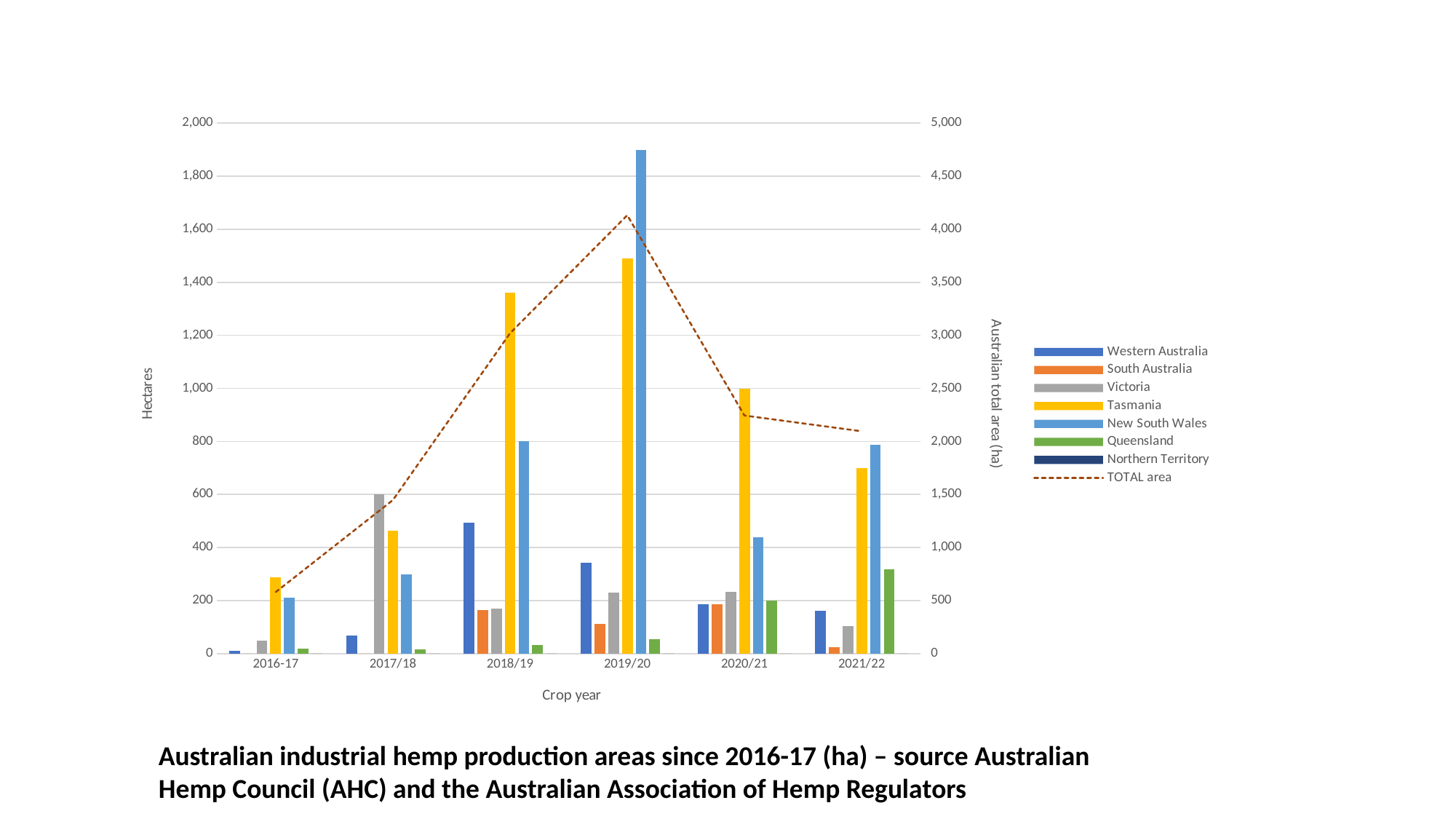
How many entries does the legend list? 8 How many crop years are shown on the x axis? 6 In which crop year does the TOTAL area line reach its peak? 2019/20 In 2018/19, which is larger: the Tasmania bar or the New South Wales bar? Tasmania What kind of chart is shown on the slide? bar chart (with a dashed line for total area) Does the TOTAL area line rise or fall from 2016-17 to 2019/20? rise Which state has the tallest bar in 2019/20? New South Wales Is the value for Tasmania in 2018/19 greater or less than 1,200 hectares? greater In which crop year is the TOTAL area line at its lowest? 2016-17 What is the label of the right-hand vertical axis? Australian total area (ha) Is the value for New South Wales in 2019/20 greater or less than 1,800 hectares? greater Which state has the tallest bar in 2017/18? Victoria